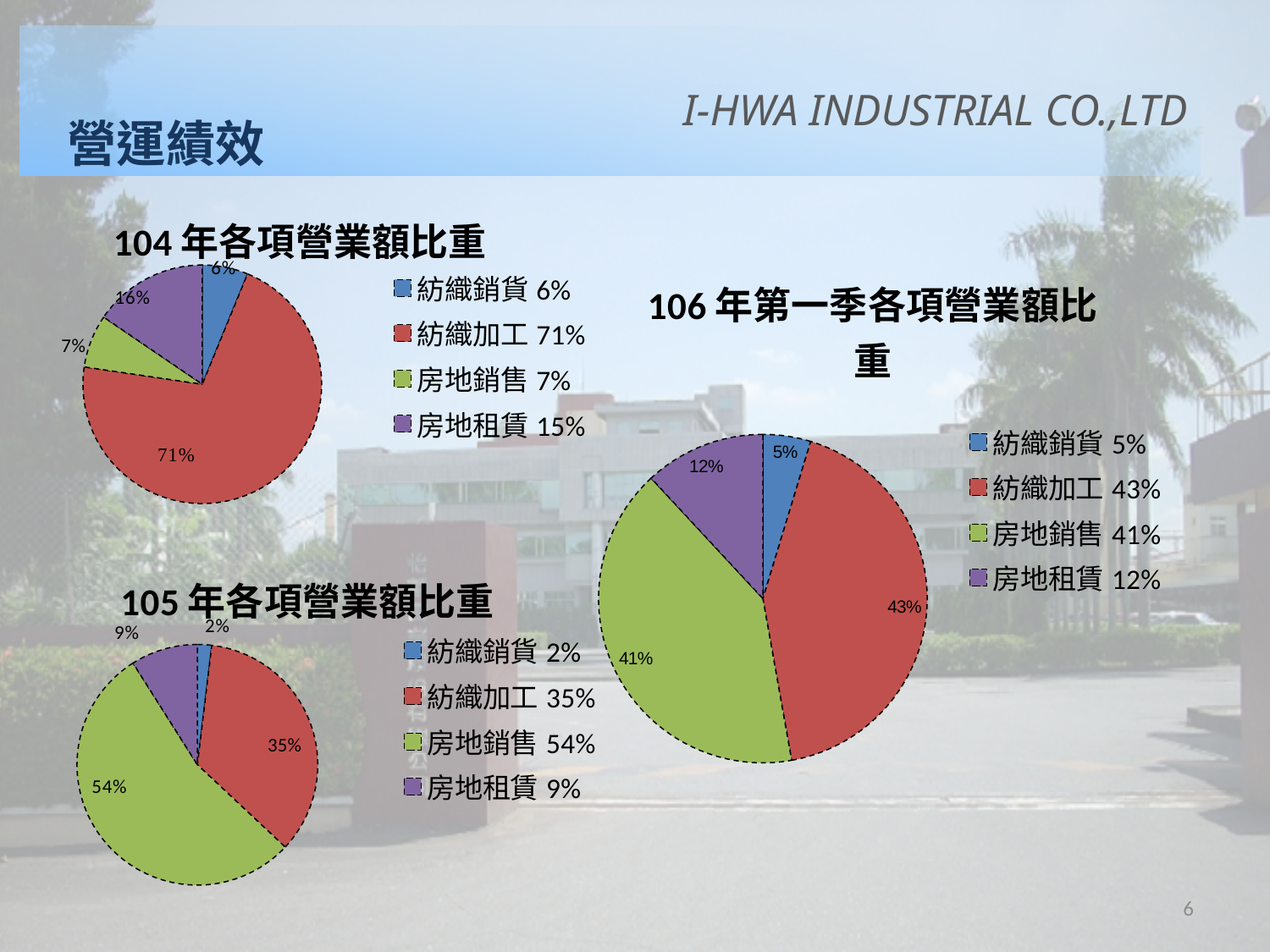
What kind of chart is the "104 年各項營業額比重" chart? pie chart In the "106 年第一季各項營業額比重" chart, what is the value for 紡織加工? 43% In the "106 年第一季各項營業額比重" chart, what is the difference between 紡織加工 and 房地銷售? 2% In the "106 年第一季各項營業額比重" chart, which is larger, 房地租賃 or 紡織銷貨? 房地租賃 How many pie charts are shown on the slide? 3 In the "105 年各項營業額比重" chart, which category has the smallest share? 紡織銷貨 In the "104 年各項營業額比重" chart, which category has the largest share? 紡織加工 In the "105 年各項營業額比重" chart, what share does 房地銷售 have? 54% In the "105 年各項營業額比重" chart, how many categories does the legend list? 4 In the "104 年各項營業額比重" chart, what is the value for 紡織銷貨? 6% In the "105 年各項營業額比重" chart, what is the difference between 房地銷售 and 紡織加工? 19% In the "104 年各項營業額比重" chart, what share does 紡織加工 have? 71%